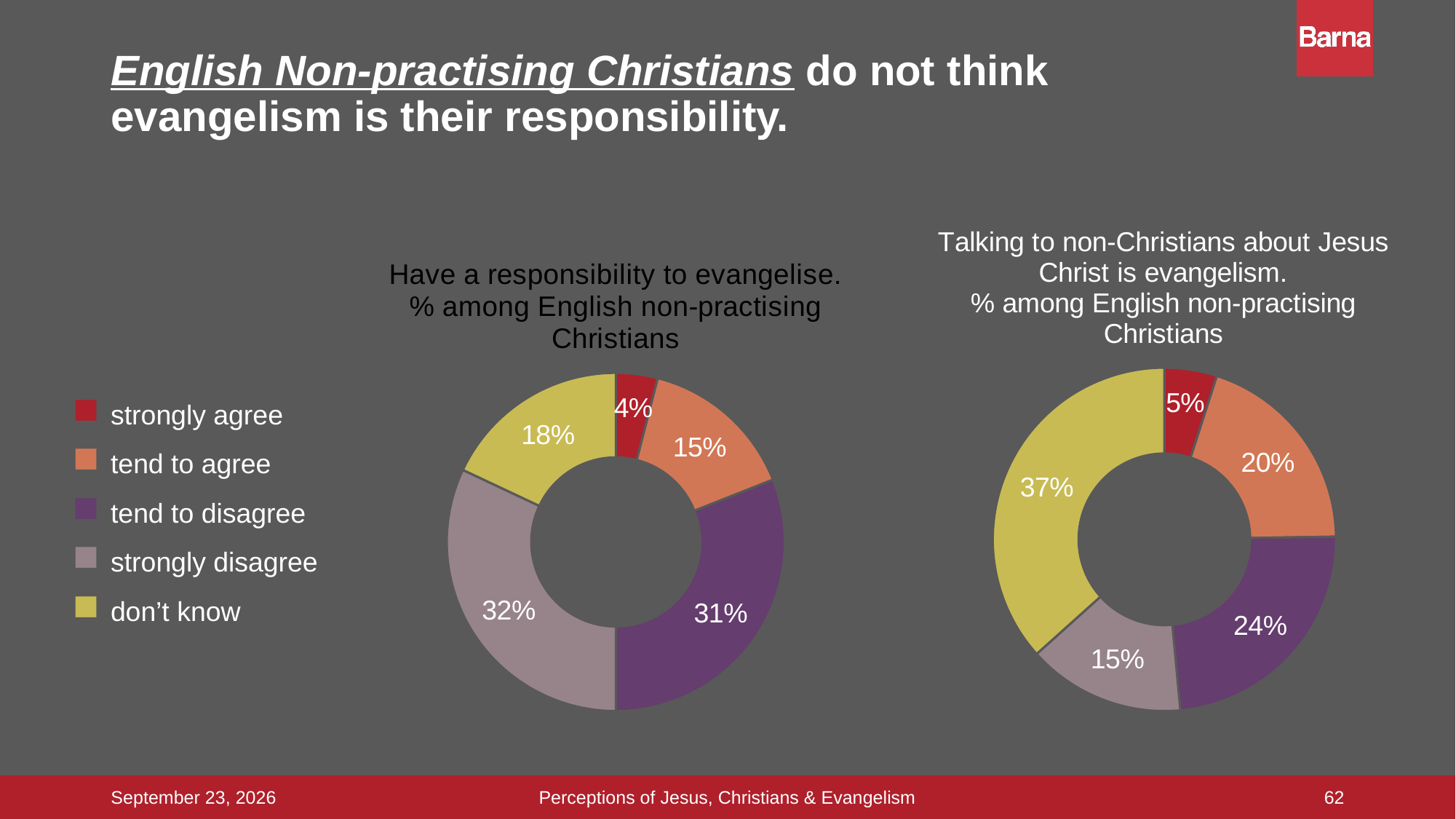
In the 'Have a responsibility to evangelise' chart, what percentage is shown for 'strongly disagree'? 32% In the 'Have a responsibility to evangelise' chart, which category has the largest share? strongly disagree In the 'Talking to non-Christians about Jesus Christ is evangelism' chart, which category has the smallest share? strongly agree How many categories does the legend list? 5 How many charts are shown on the slide? 2 In the 'Talking to non-Christians about Jesus Christ is evangelism' chart, what percentage is shown for 'don't know'? 37% In the 'Have a responsibility to evangelise' chart, what is the difference between 'tend to disagree' and 'tend to agree'? 16 percentage points Which colour represents 'don't know' in the legend? Yellow What type of chart is used on this slide? Doughnut chart In the 'Talking to non-Christians about Jesus Christ is evangelism' chart, what percentage is shown for 'tend to disagree'? 24% In the 'Have a responsibility to evangelise' chart, what is the combined share of 'strongly agree' and 'tend to agree'? 19% In the 'Talking to non-Christians about Jesus Christ is evangelism' chart, which is larger: 'tend to agree' or 'strongly disagree'? tend to agree